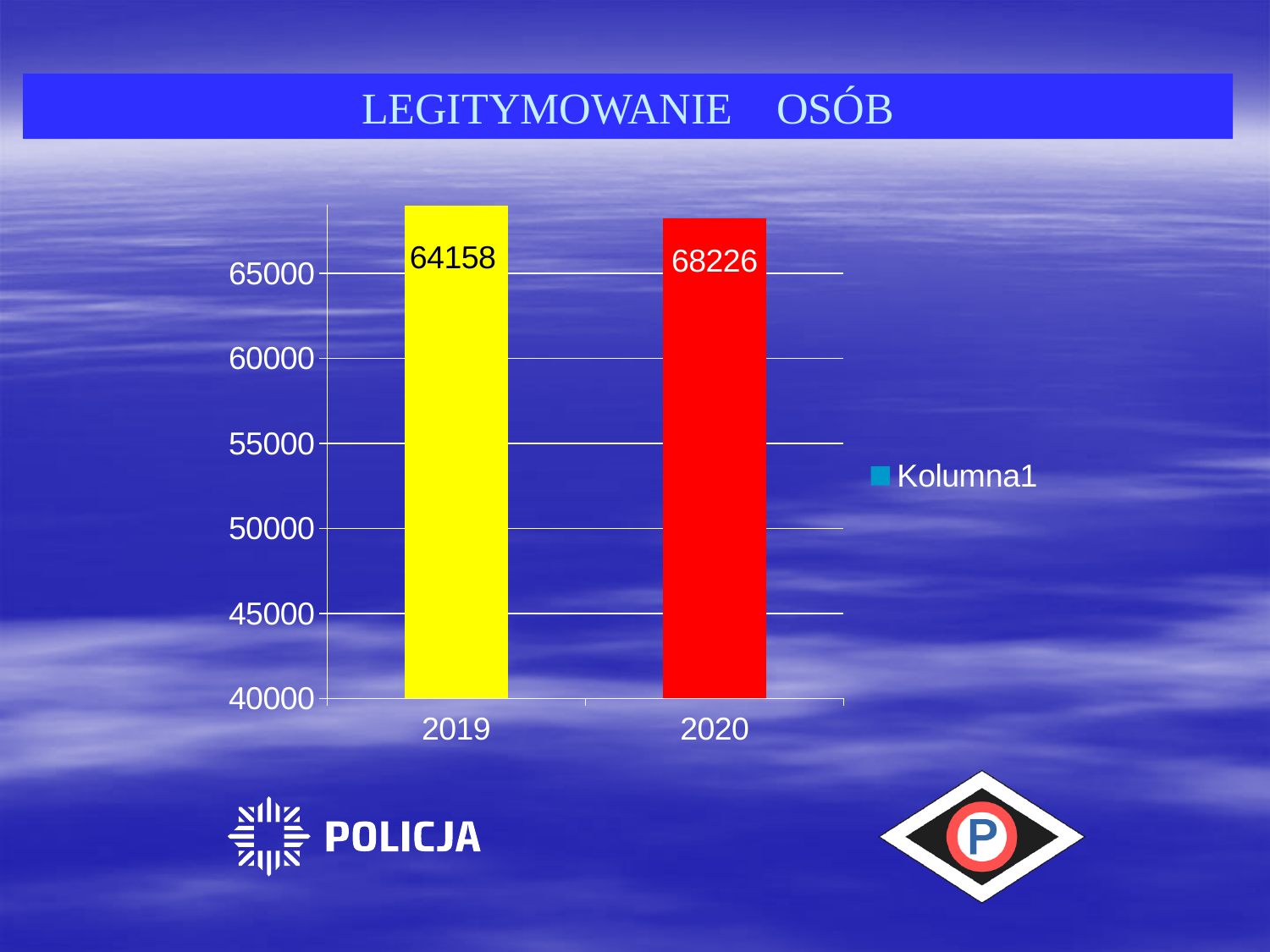
What is the title of the chart? LEGITYMOWANIE OSÓB What kind of chart is shown on the slide? bar chart Is the value for 2019 greater or less than 60000? greater What is the value for 2020? 68226 What is the difference between the values for 2020 and 2019? 4068 How many categories are shown on the x axis? 2 How many series does the legend list? 1 What is the value for 2019? 64158